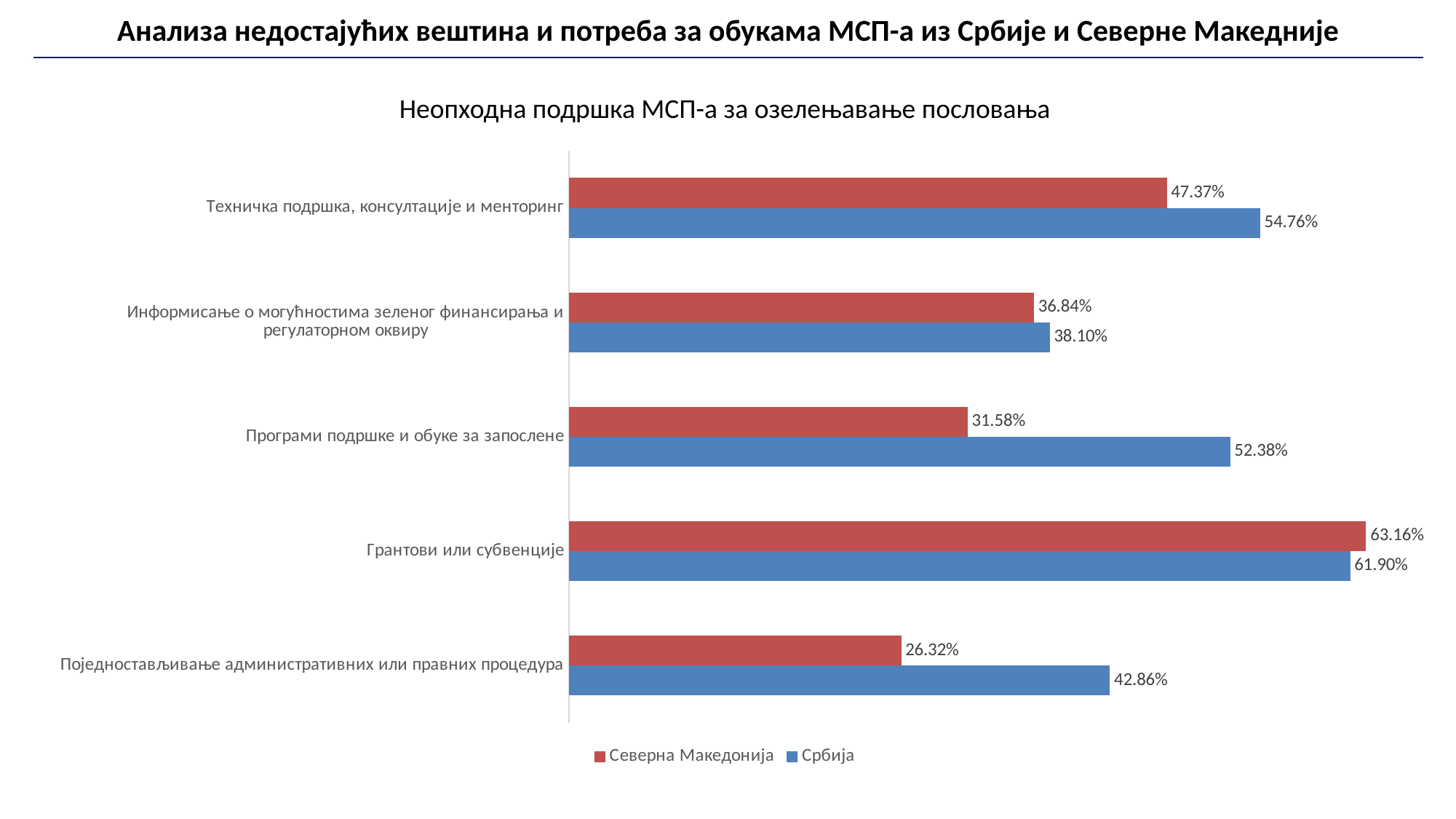
What is the value for Србија for Техничка подршка, консултације и менторинг? 54.76% What is the value for Северна Македонија for Поједностављивање административних или правних процедура? 26.32% What is the title of the chart? Неопходна подршка МСП-а за озелењавање пословања What is the difference between the Србија and Северна Македонија values for Програми подршке и обуке за запослене? 20.80% For Поједностављивање административних или правних процедура, which series has the larger value, Србија or Северна Македонија? Србија Which category has the highest value for Србија? Грантови или субвенције How many series does the legend list? 2 Which category has the lowest value for Северна Македонија? Поједностављивање административних или правних процедура What kind of chart is shown on the slide? Bar chart How many categories are shown in the chart? 5 What is the value for Северна Македонија for Грантови или субвенције? 63.16% Which colour represents Србија in the chart? Blue